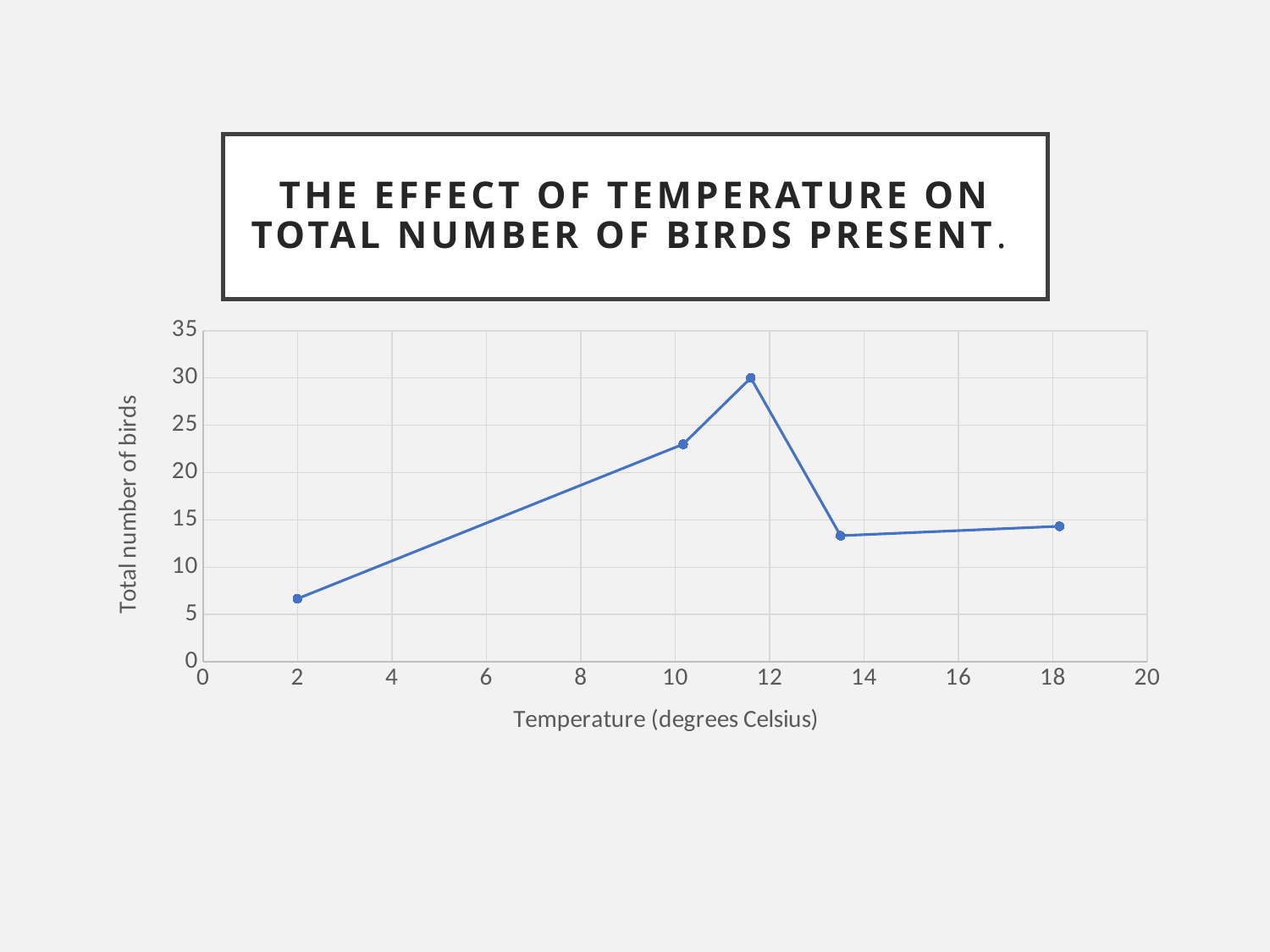
Is the value for the data point at 2 degrees Celsius greater or less than 10? less Is the value for the data point just above 10 degrees Celsius greater or less than 20? greater Is the value for the data point between 12 and 14 degrees Celsius greater or less than 15? less Does the total number of birds rise or fall as temperature increases from 2 degrees to about 12 degrees Celsius? rise What is the label on the y axis of the chart? Total number of birds What is the label on the x axis of the chart? Temperature (degrees Celsius) What kind of chart is shown on the slide? line chart How many data points are plotted on the chart? 5 Which has more birds: the data point at 2 degrees Celsius or the data point near 18 degrees Celsius? the data point near 18 degrees Celsius